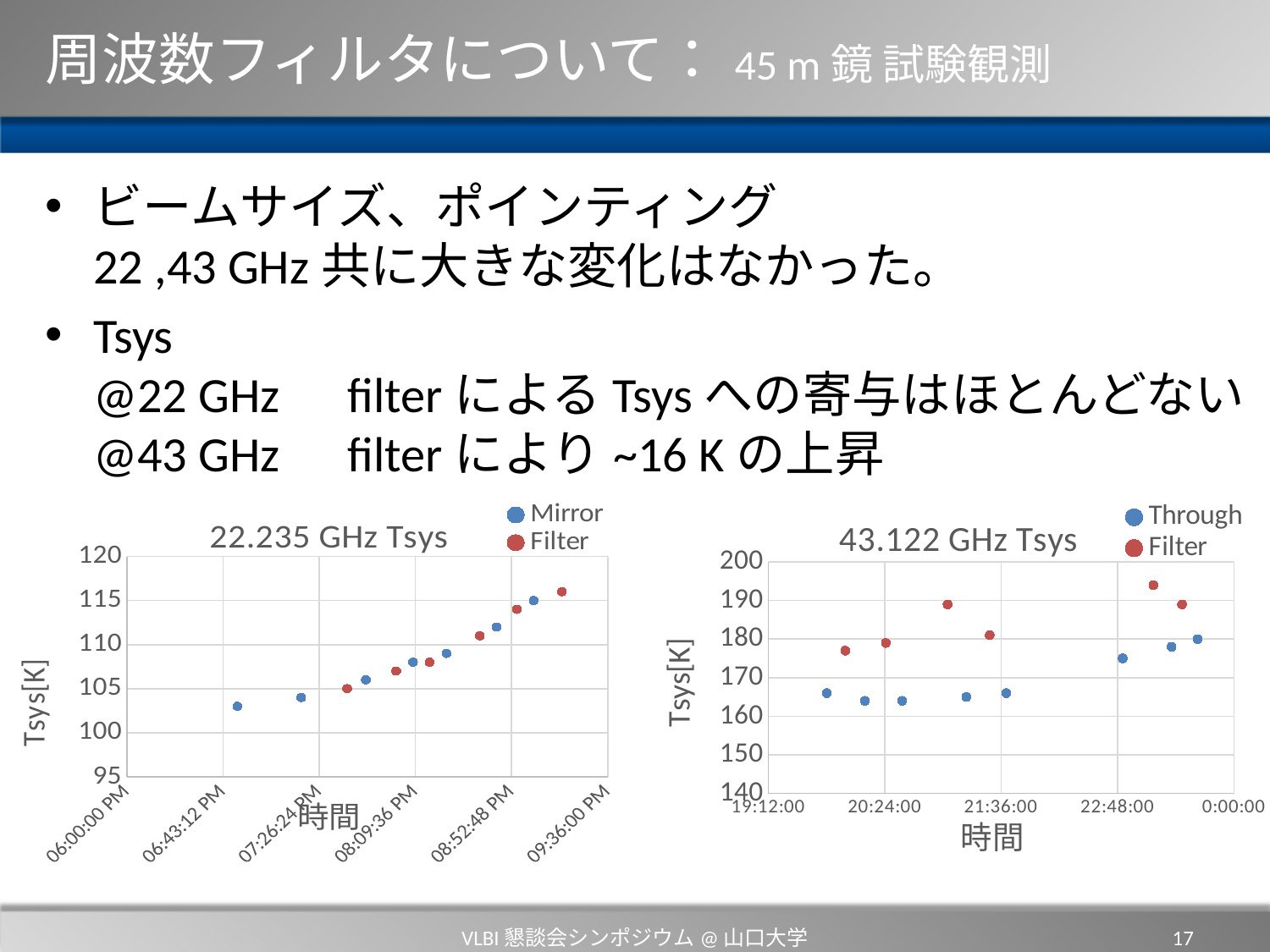
In the 43.122 GHz Tsys chart, are the Through values before 22:48:00 greater or less than 170? less How many series does the legend of the 22.235 GHz Tsys chart list? 2 What is the y-axis label of the 43.122 GHz Tsys chart? Tsys[K] How many Filter points are plotted in the 43.122 GHz Tsys chart? 6 In the 43.122 GHz Tsys chart, which series has the higher values overall, Through or Filter? Filter In the 22.235 GHz Tsys chart, do the Tsys values rise or fall as time increases along the x axis? rise In the 43.122 GHz Tsys chart, which series contains the highest plotted point? Filter In the 43.122 GHz Tsys chart, is the highest Filter value greater or less than 190? greater What is the maximum value shown on the y axis of the 22.235 GHz Tsys chart? 120 In the 22.235 GHz Tsys chart, is the lowest Mirror value greater or less than 100? greater What are the two legend entries of the 43.122 GHz Tsys chart on the right? Through and Filter What kind of chart is the 22.235 GHz Tsys chart on the left? scatter chart